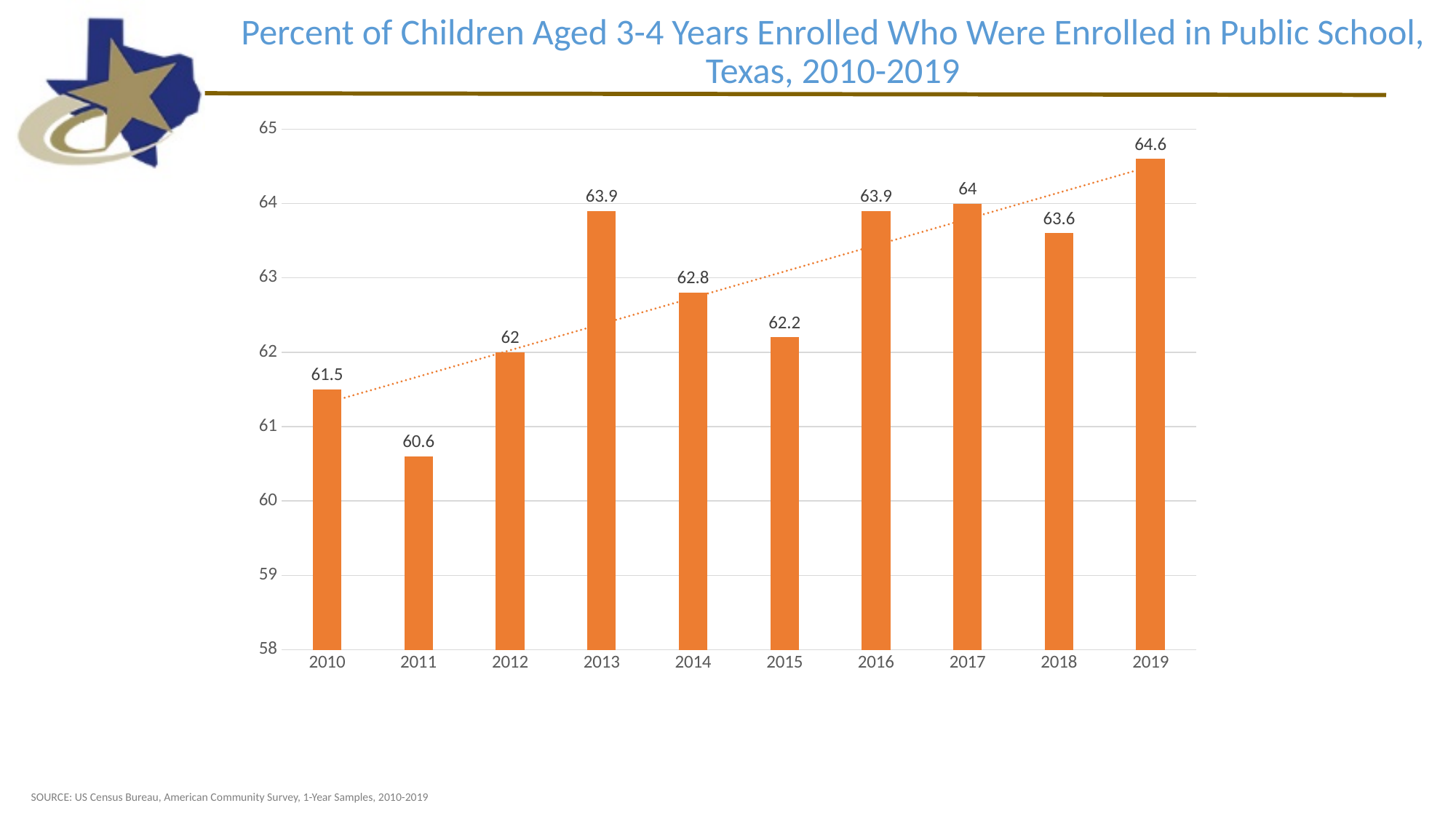
What is the value for 2010? 61.5 Does the dotted trend line rise or fall from 2010 to 2019? rise What is the difference between the values for 2014 and 2013? 1.1 Which year has the lowest value? 2011 Is the value for 2017 greater or less than 63? greater What kind of chart is this? bar chart What is the value for 2018? 63.6 Which year has the highest value? 2019 What is the difference between the values for 2019 and 2011? 4 Which is larger, the value for 2012 or the value for 2015? 2015 What is the value for 2015? 62.2 How many years are shown on the x axis? 10